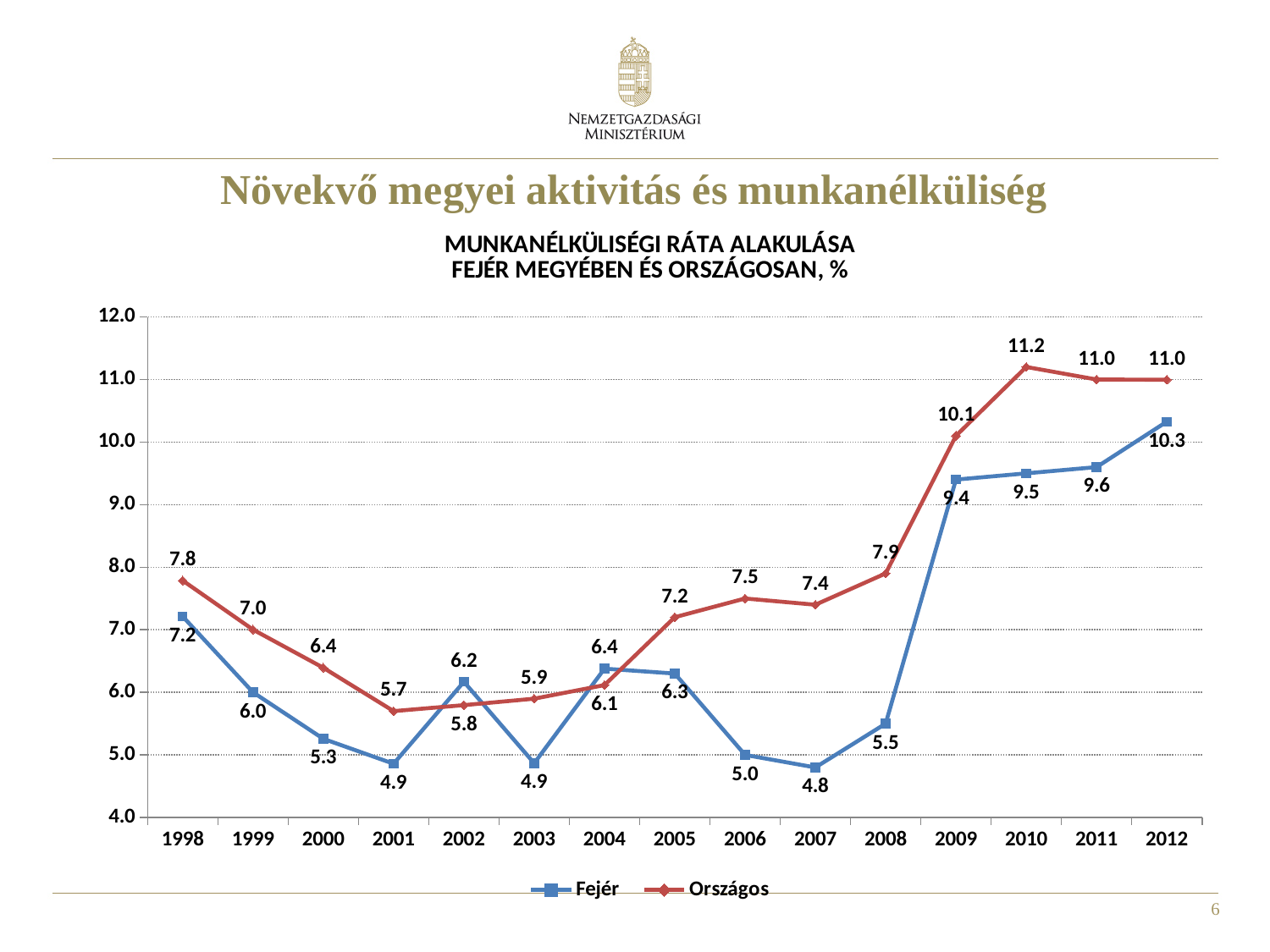
What type of chart is shown on the slide? line chart Which series is drawn in red? Országos What is the difference between the Országos and Fejér values in 2009? 0.7 In which year is the Országos series at its highest? 2010 Which series has the higher value in 2004, Fejér or Országos? Fejér What is the Fejér value in 2012? 10.3 What is the Országos value in 2010? 11.2 What is the Fejér value in 2002? 6.2 How many years are plotted along the x axis? 15 Does the Országos series rise or fall between 2008 and 2010? rise In which year is the Fejér series at its lowest? 2007 How many series does the legend list? 2